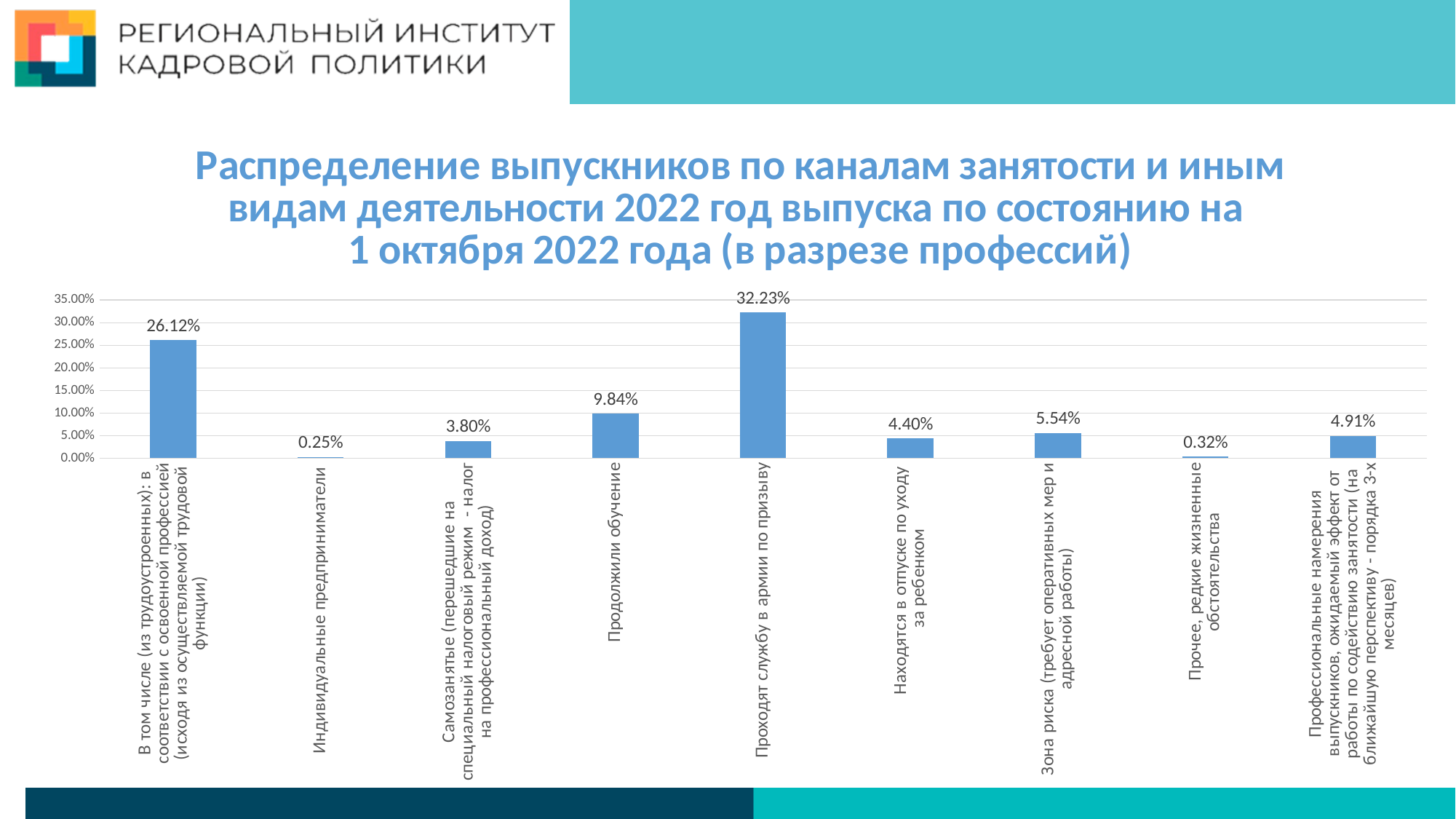
What is the maximum value shown on the vertical axis? 35.00% What is the value for "Зона риска (требует оперативных мер и адресной работы)"? 5.54% What is the value for "Продолжили обучение"? 9.84% Is the value for "Продолжили обучение" greater or less than 5.00%? greater What is the difference between the values for "Проходят службу в армии по призыву" and "Продолжили обучение"? 22.39% How many categories are shown on the chart? 9 Which category has the highest value? Проходят службу в армии по призыву What kind of chart is shown on the slide? Bar chart Which category has the lowest value? Индивидуальные предприниматели What is the value for "Проходят службу в армии по призыву"? 32.23% What is the value for "Индивидуальные предприниматели"? 0.25% Which is larger: the value for "Находятся в отпуске по уходу за ребенком" or the value for "Зона риска (требует оперативных мер и адресной работы)"? Зона риска (требует оперативных мер и адресной работы)